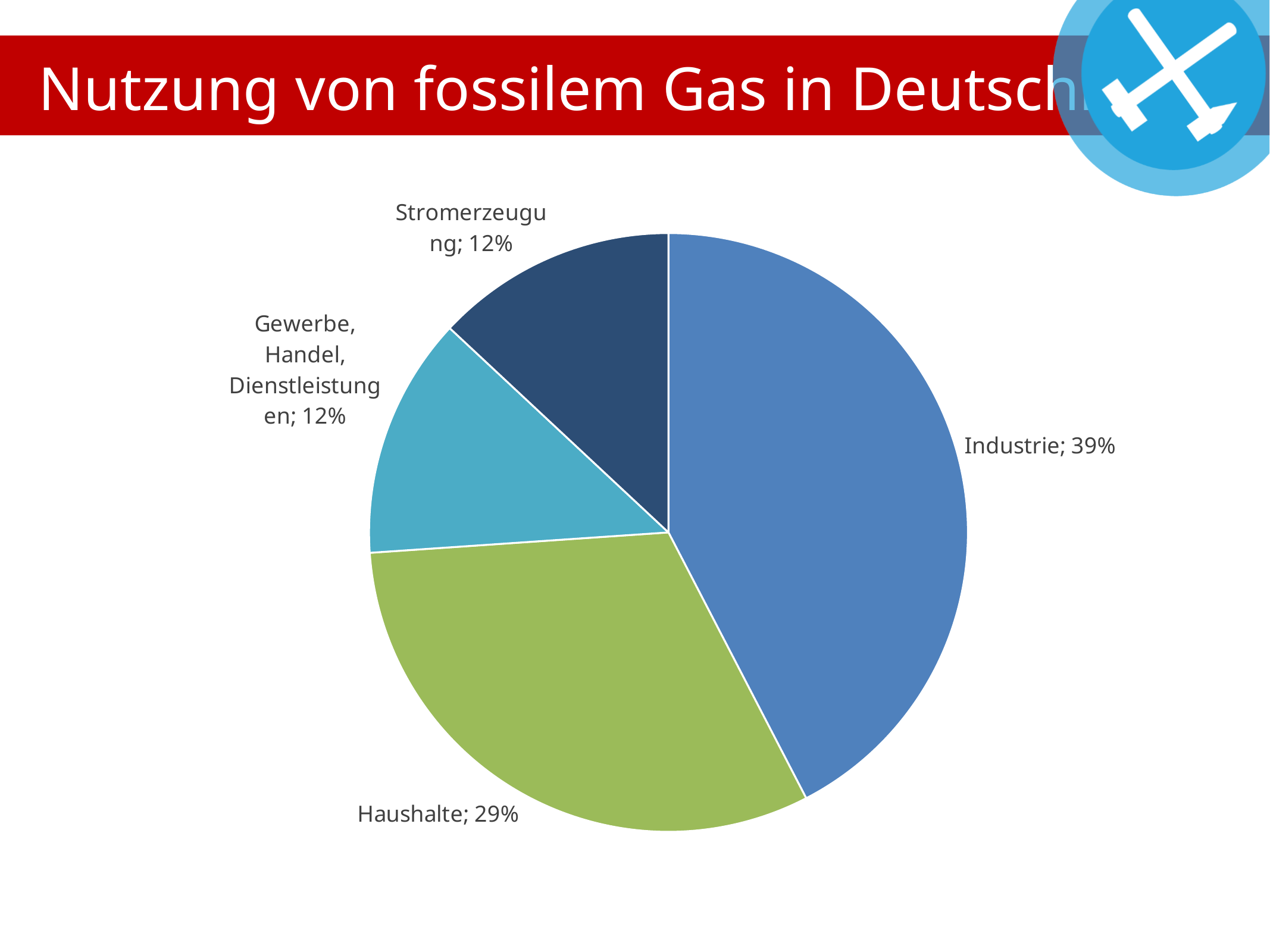
What is the difference in percentage points between Haushalte and Stromerzeugung? 17 What share of the pie does Industrie account for? 39% How many slices does the pie chart have? 4 What share of the pie does Gewerbe, Handel, Dienstleistungen account for? 12% What kind of chart is shown on the slide? pie chart Which is larger, the slice for Industrie or the slice for Haushalte? Industrie What colour is the Haushalte slice? green What is the difference in percentage points between Industrie and Haushalte? 10 What share of the pie does Haushalte account for? 29% What share of the pie does Stromerzeugung account for? 12% Which category has the largest slice of the pie? Industrie What is the combined share of Industrie and Haushalte? 68%